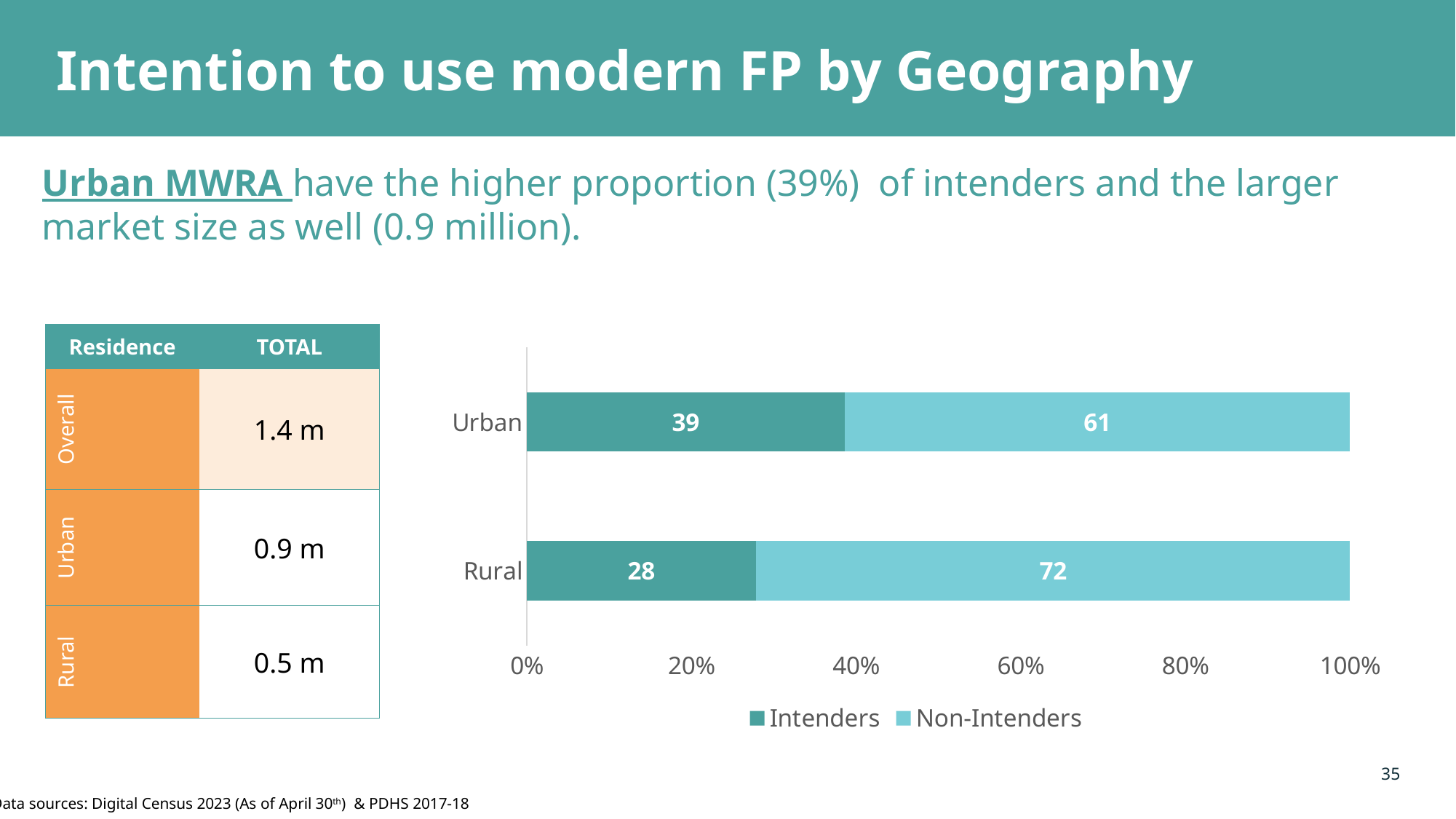
What is the Intenders value for Urban? 39 What is the Non-Intenders value for Urban? 61 What is the difference between the Intenders values for Urban and Rural? 11 What kind of chart is shown on the slide? Stacked bar chart What is the Intenders value for Rural? 28 How many categories are shown on the chart? 2 What is the Non-Intenders value for Rural? 72 Which category has the lower Non-Intenders value? Urban How many series does the legend list? 2 Which category has the higher Intenders value? Urban What is the total of the stacked bar for Rural? 100 Is the Non-Intenders value for Rural larger than the Non-Intenders value for Urban? Yes